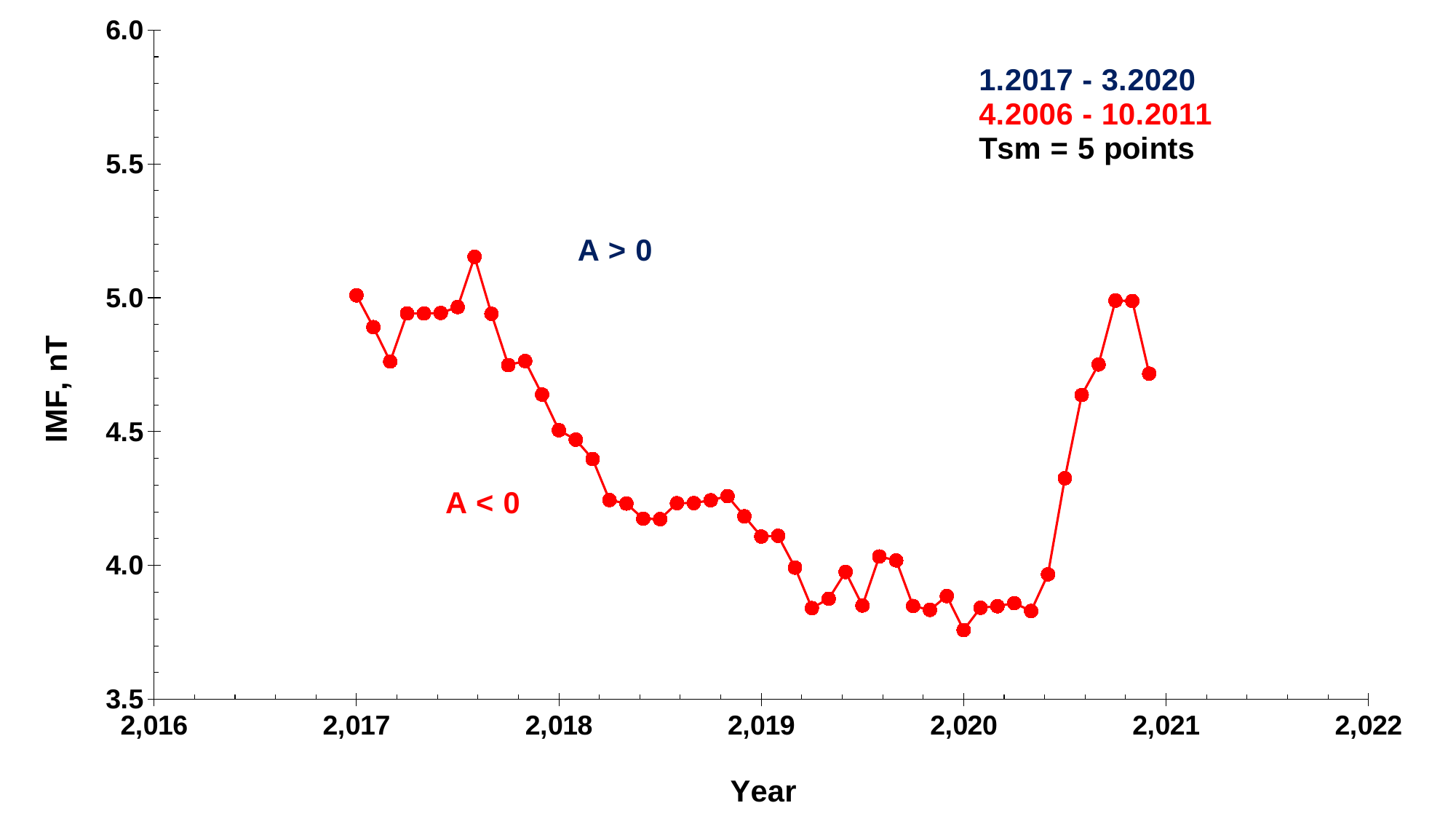
Do the values generally rise or fall between 2017 and 2020? fall What is the label of the y axis? IMF, nT Is the lowest value of the line greater or less than 3.5? greater Is the value at the year 2020 greater or less than 4.0? less Is the value at the year 2019 greater or less than 4.5? less Which is larger, the value at 2018 or the value at 2019? 2018 Which is larger, the value at 2017 or the value at 2020? 2017 What kind of chart is shown on the slide? line chart What is the label of the x axis? Year Do the values rise or fall between 2020 and the end of the series near 2021? rise